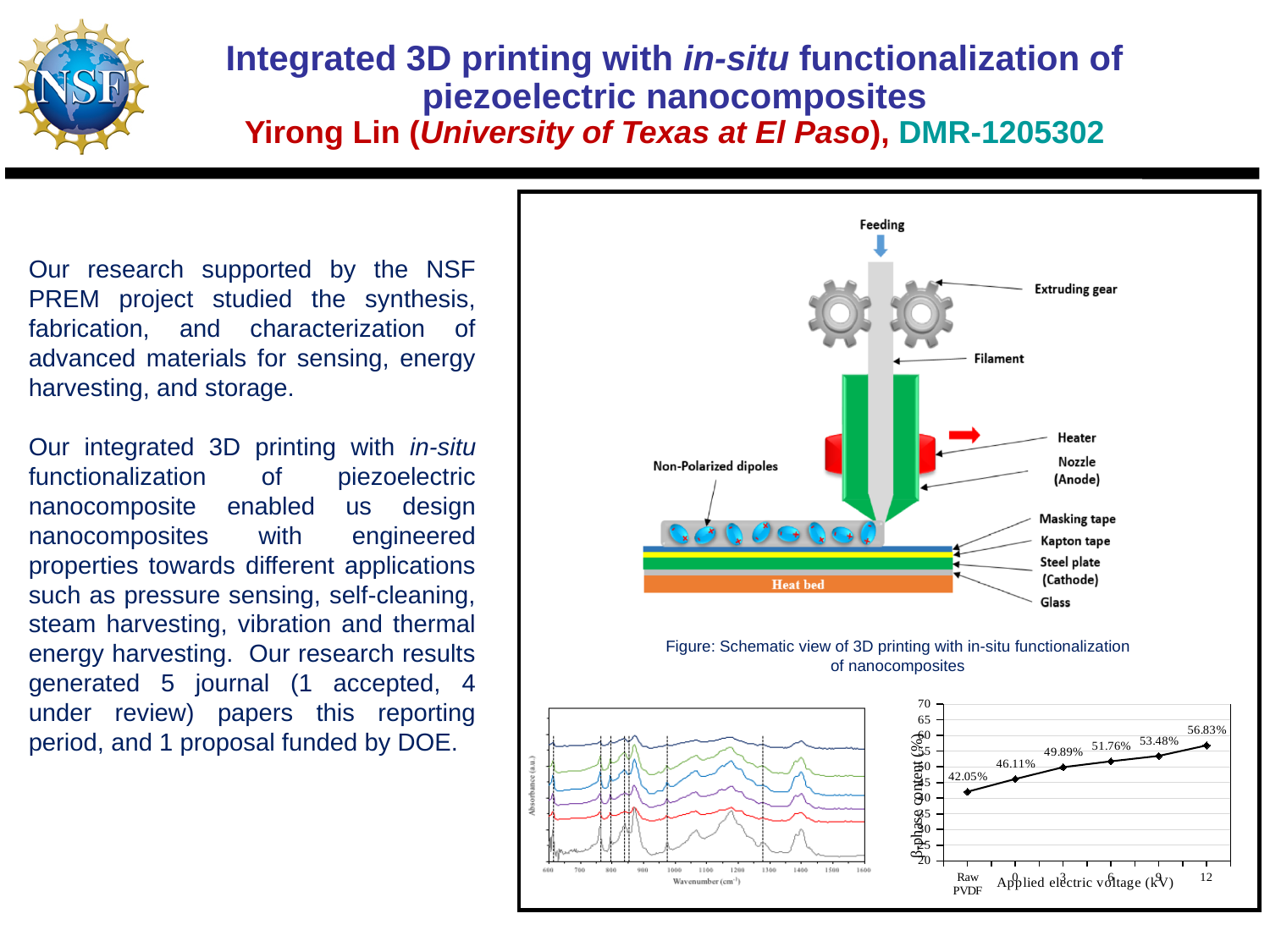
In the line chart of β-phase content versus applied electric voltage, what is the β-phase content at 12 kV? 56.83% In the line chart of β-phase content versus applied electric voltage, which x-axis category has the lowest β-phase content? Raw PVDF In the line chart of β-phase content versus applied electric voltage, what is the difference in β-phase content between 12 kV and Raw PVDF? 14.78% In the line chart of β-phase content versus applied electric voltage, which has a higher β-phase content, 3 kV or 9 kV? 9 kV In the line chart of β-phase content versus applied electric voltage, what is the β-phase content at 0 kV? 46.11% What kind of chart is the bottom-right chart showing β-phase content versus applied electric voltage? Line chart In the line chart of β-phase content versus applied electric voltage, how many data points are plotted? 6 What is the x-axis title of the bottom-right line chart? Applied electric voltage (kV) In the line chart of β-phase content versus applied electric voltage, do the values rise or fall as the applied voltage increases along the x axis? Rise In the line chart of β-phase content versus applied electric voltage, which x-axis category has the highest β-phase content? 12 In the line chart of β-phase content versus applied electric voltage, what is the β-phase content for Raw PVDF? 42.05% In the line chart of β-phase content versus applied electric voltage, what is the β-phase content at 6 kV? 51.76%